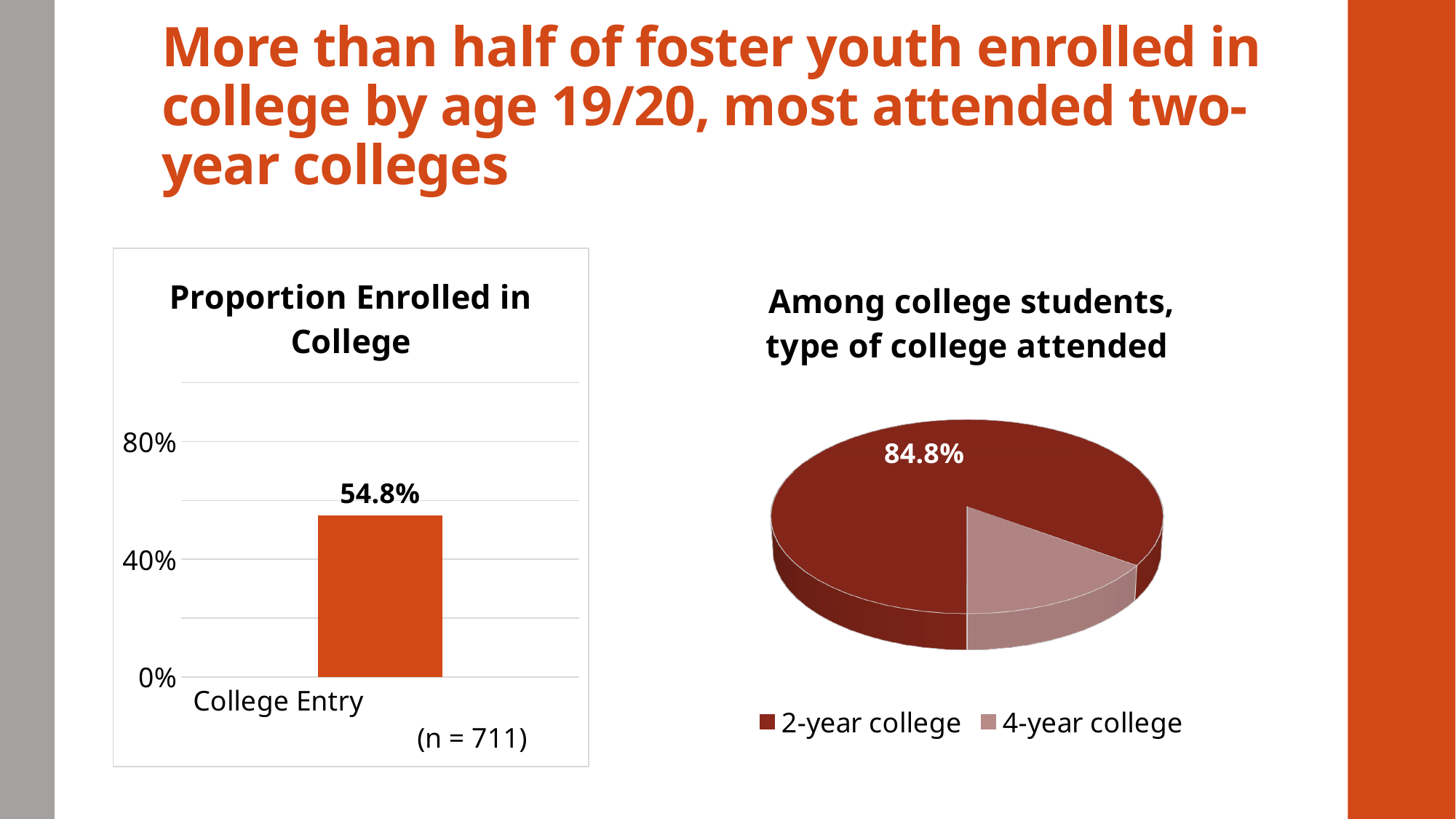
In the 'Among college students, type of college attended' pie chart, which is larger: 2-year college or 4-year college? 2-year college In the 'Among college students, type of college attended' pie chart, what share is 2-year college? 84.8% In the 'Among college students, type of college attended' pie chart, which slice is the smallest? 4-year college What sample size is noted on the 'Proportion Enrolled in College' chart? n = 711 In the 'Proportion Enrolled in College' chart, is the value for College Entry greater or less than 40%? greater What kind of chart is the 'Proportion Enrolled in College' chart? bar chart In the 'Proportion Enrolled in College' chart, is the value for College Entry greater or less than 80%? less How many categories does the legend of the 'Among college students, type of college attended' pie chart list? 2 In the 'Among college students, type of college attended' pie chart, which slice is the largest? 2-year college What kind of chart is the 'Among college students, type of college attended' chart? pie chart How many bars are plotted in the 'Proportion Enrolled in College' chart? 1 In the 'Proportion Enrolled in College' chart, what is the value for College Entry? 54.8%